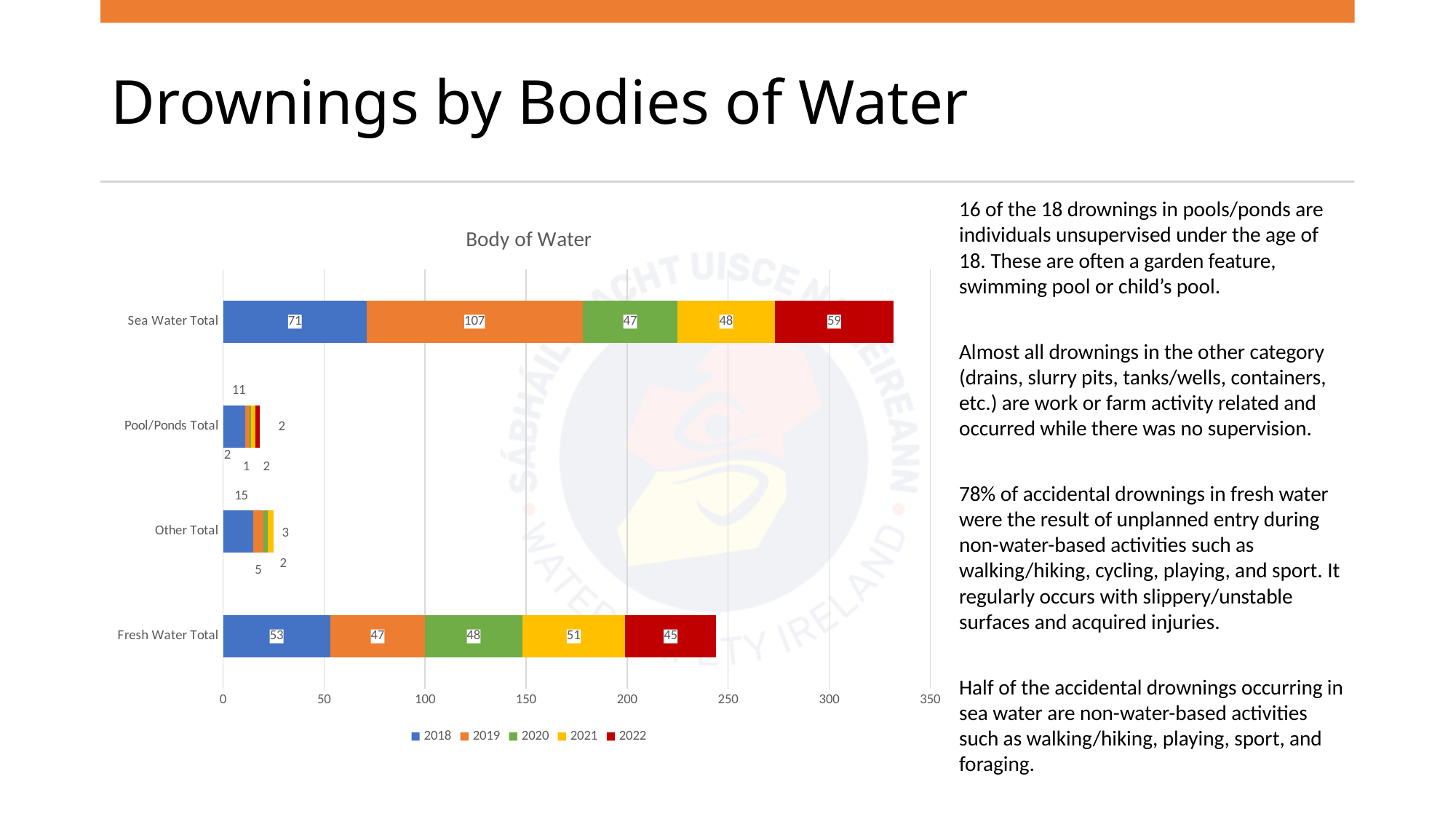
What is the total of the stacked bar for Sea Water Total? 332 What is the 2018 value for Fresh Water Total? 53 What is the difference between the 2019 value for Sea Water Total and the 2019 value for Fresh Water Total? 60 How many body-of-water categories are shown on the chart? 4 Which body of water has the longest stacked bar overall? Sea Water Total What is the 2019 value for Sea Water Total? 107 What is the 2022 value for Sea Water Total? 59 What is the 2021 value for Fresh Water Total? 51 What is the total of the stacked bar for Fresh Water Total? 244 What kind of chart is shown on the slide? Stacked bar chart Which is larger: the 2020 value for Sea Water Total or the 2020 value for Fresh Water Total? Fresh Water Total How many series does the legend list? 5